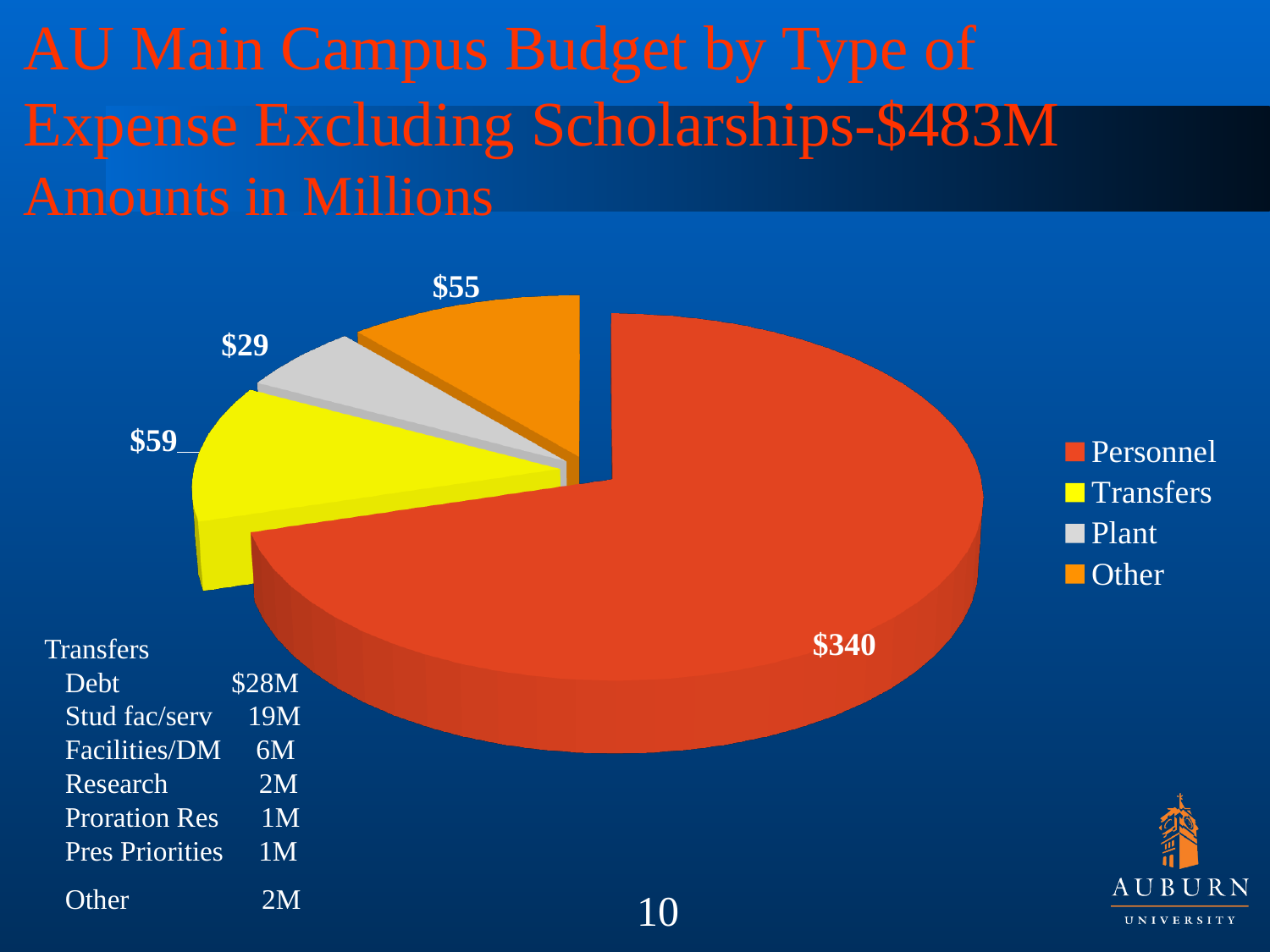
What type of chart is shown on the slide? Pie chart Which expense type has the smallest slice of the pie? Plant What colour is the Plant slice in the pie chart? Grey What is the value of the Transfers slice? $59 What is the difference between the Personnel and Transfers values? $281 What is the value of the Plant slice? $29 Which expense type has the largest slice of the pie? Personnel How many slices does the pie chart have? 4 Which is larger, the Transfers slice or the Other slice? Transfers What is the value of the Other slice? $55 How many entries are listed in the chart legend? 4 What is the value of the Personnel slice? $340